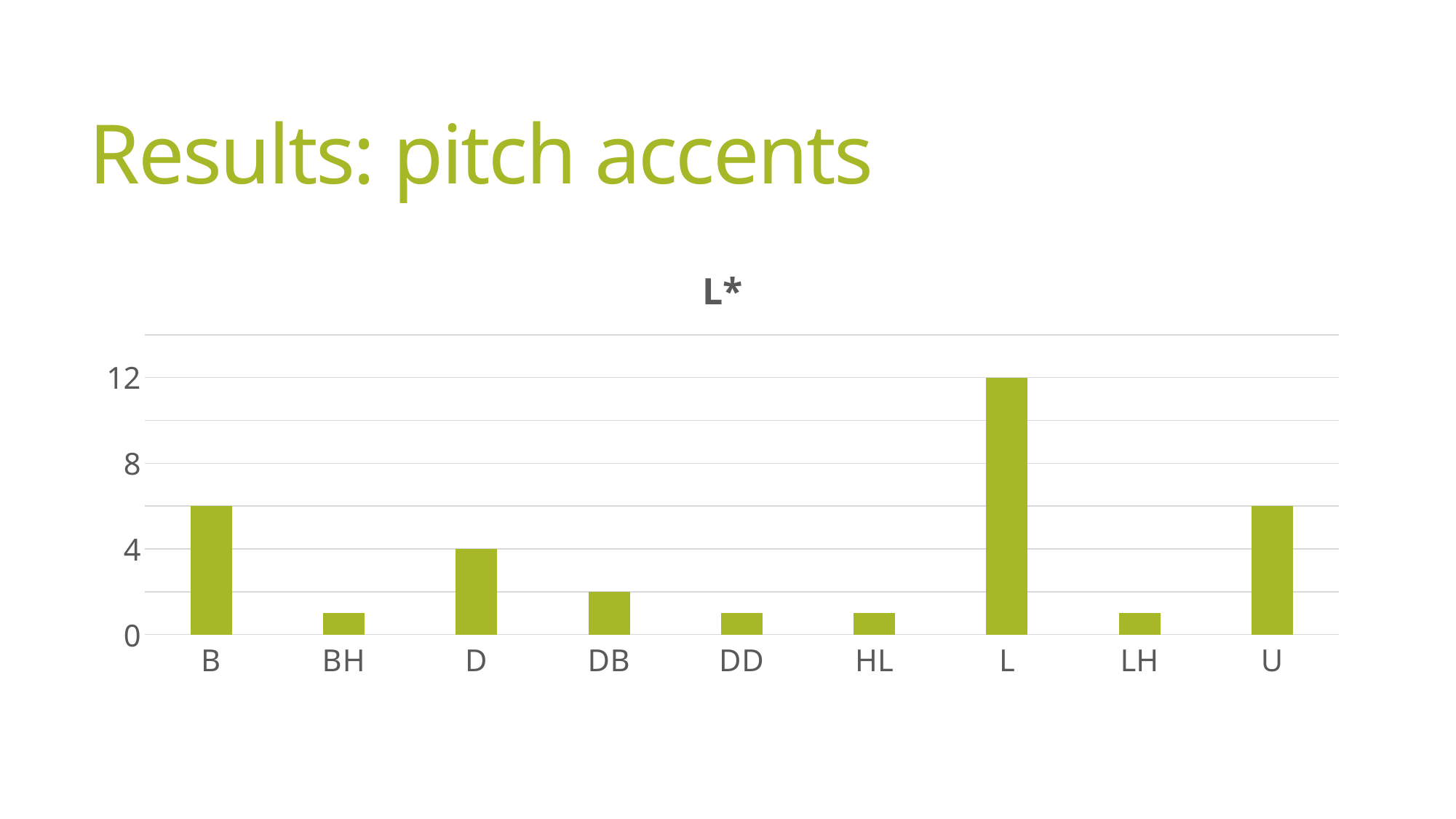
Is the value for U greater or less than 8? less How many categories are shown on the x axis of the chart? 9 What is the title of the chart? L* What is the value for D? 4 Is the value for B greater or less than 4? greater Which is larger, the value for B or the value for D? B Is the value for BH greater or less than 4? less Which category has the highest value in the chart? L What type of chart is shown on the slide? bar chart Which is larger, the value for DB or the value for L? L What is the value for L? 12